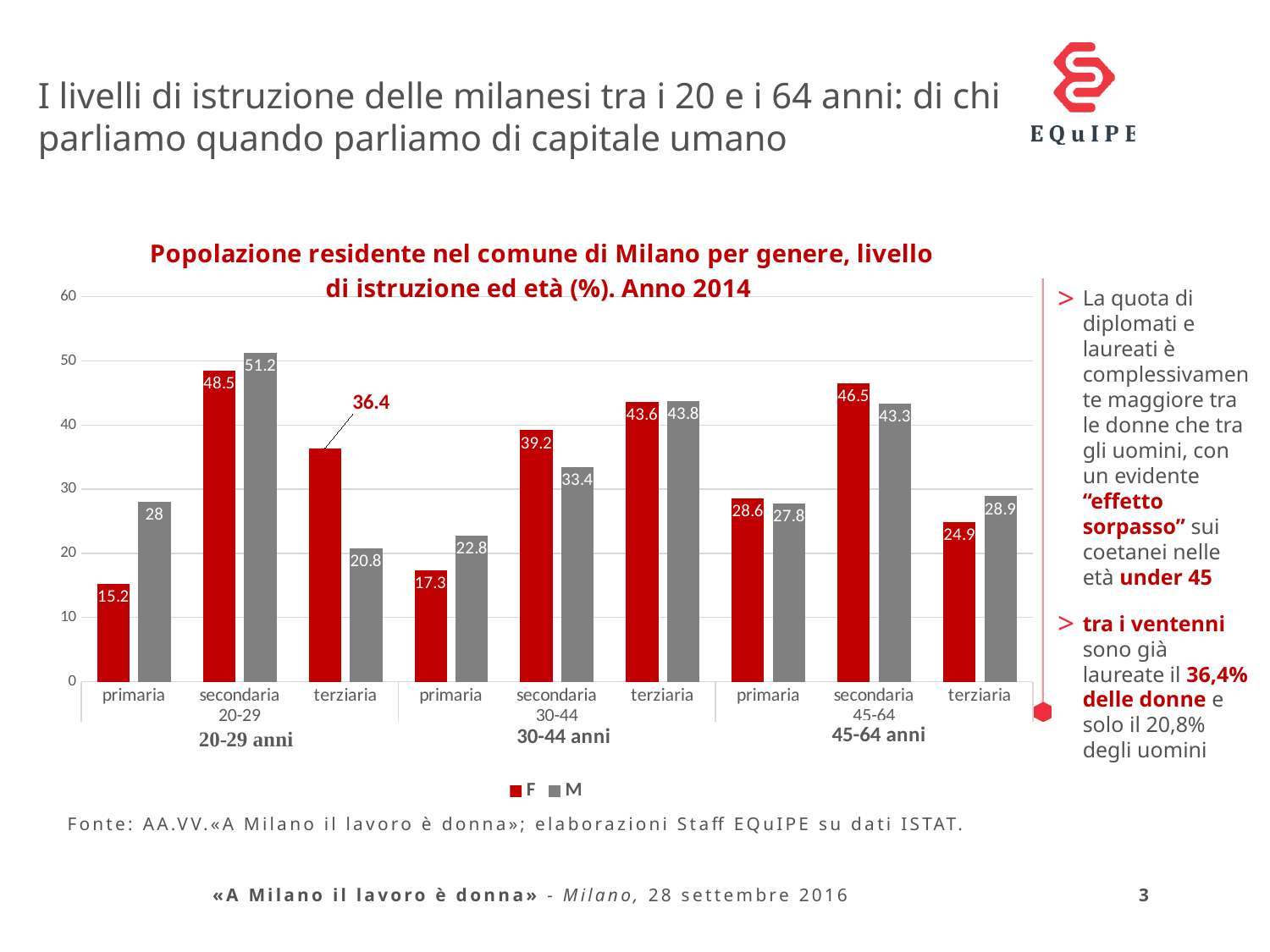
In the 'secondaria' category of the 30-44 age group, which is larger, the F value or the M value? F (39.2) What colour represents the F series in the chart? Red How many series does the legend list? 2 Which bar has the lowest value in the whole chart? F, primaria, 20-29 (15.2) Is the value for M in 'primaria' of the 20-29 age group greater or less than 30? less What is the value for F (women) in the 'terziaria' category of the 20-29 age group? 36.4 Which bar has the highest value in the whole chart? M, secondaria, 20-29 (51.2) What kind of chart is shown on the slide? Bar chart What is the value for F in the 'primaria' category of the 30-44 age group? 17.3 What is the value for M in the 'terziaria' category of the 45-64 age group? 28.9 What is the value for M (men) in the 'secondaria' category of the 20-29 age group? 51.2 What is the difference between the F and M values for 'terziaria' in the 20-29 age group? 15.6